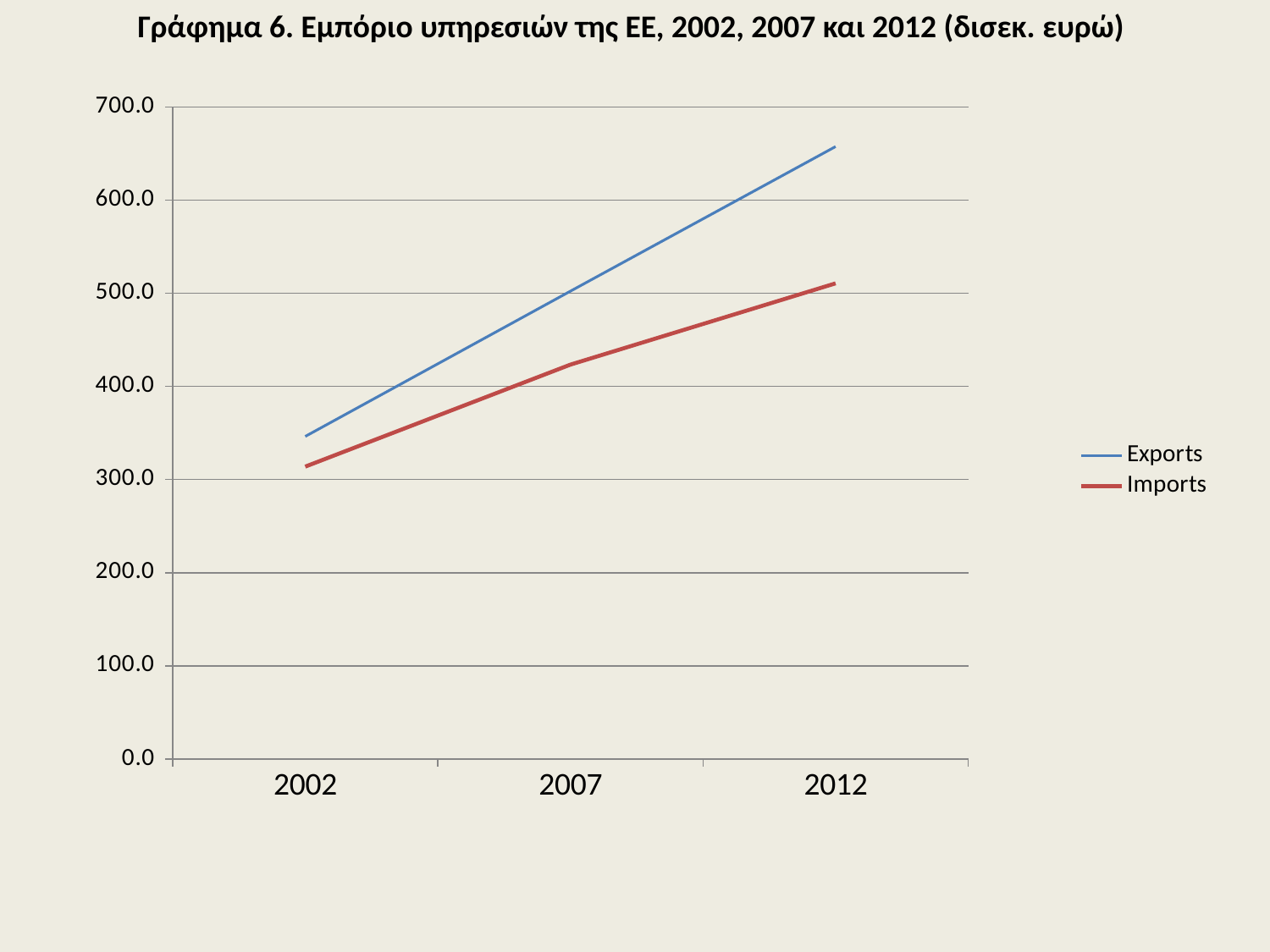
Do the Exports values rise or fall from 2002 to 2012? rise What kind of chart is shown on the slide? line chart What colour is the Imports line? red Is the Exports value for 2012 greater or less than 600? greater In 2012, which is larger, Exports or Imports? Exports In which year is the Imports value lowest? 2002 Is the Imports value for 2007 greater or less than 400? greater In which year is the Exports value highest? 2012 How many series does the legend list? 2 Do the Imports values rise or fall from 2002 to 2012? rise Is the Exports value for 2002 greater or less than 400? less How many years are plotted on the x axis? 3